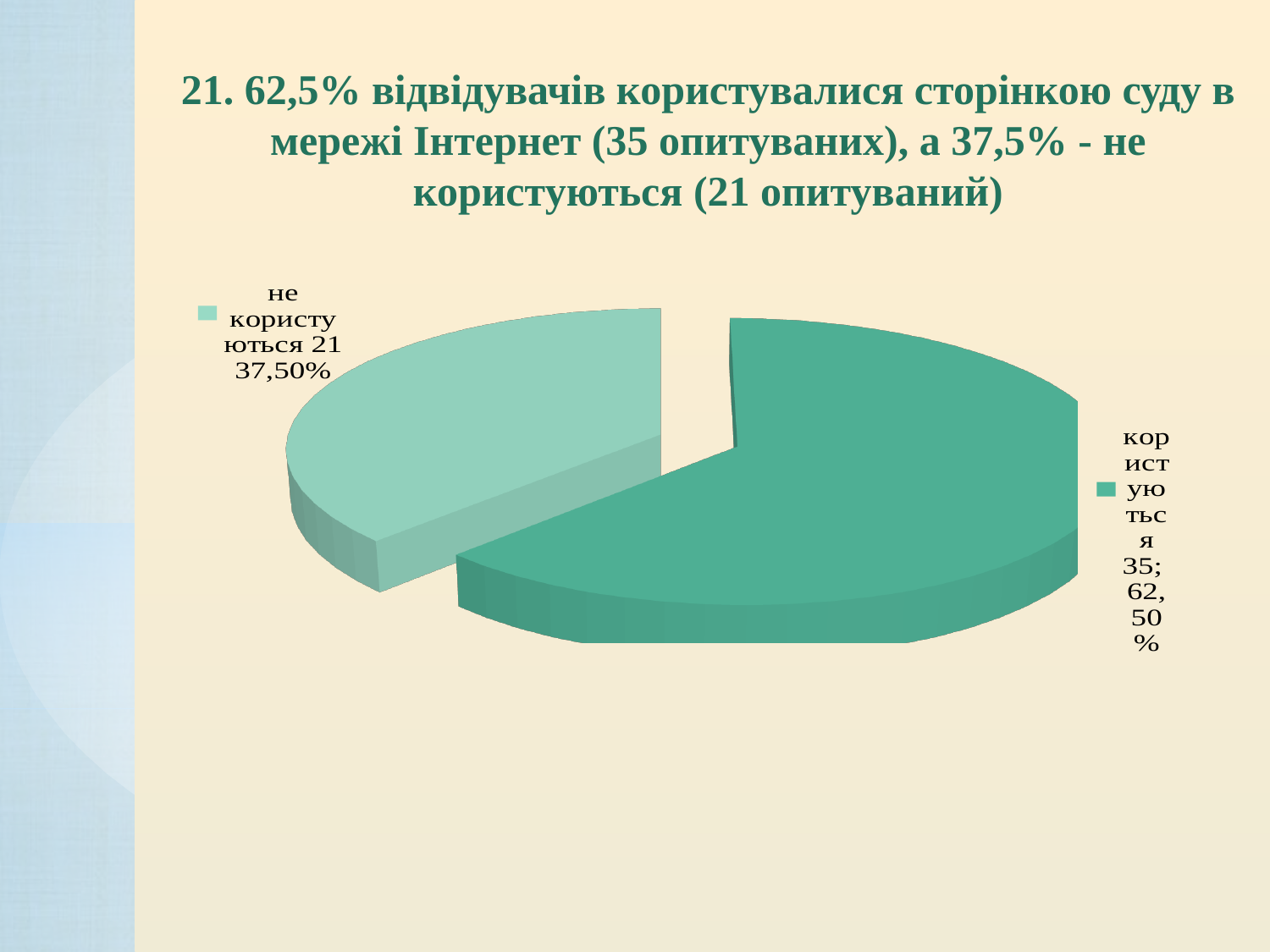
What is the value shown for the "не користуються" slice? 21 What percentage share does the "не користуються" slice have? 37,50% Which slice is the largest in the pie chart? користуються What is the difference between the values of the "користуються" and "не користуються" slices? 14 What kind of chart is shown on the slide? pie chart What is the total of the two slice values in the pie chart? 56 What is the value shown for the "користуються" slice? 35 How many slices does the pie chart have? 2 Which slice is the smallest in the pie chart? не користуються Which slice is drawn in the lighter green colour? не користуються What percentage share does the "користуються" slice have? 62,50% Which is larger: the "користуються" slice or the "не користуються" slice? користуються